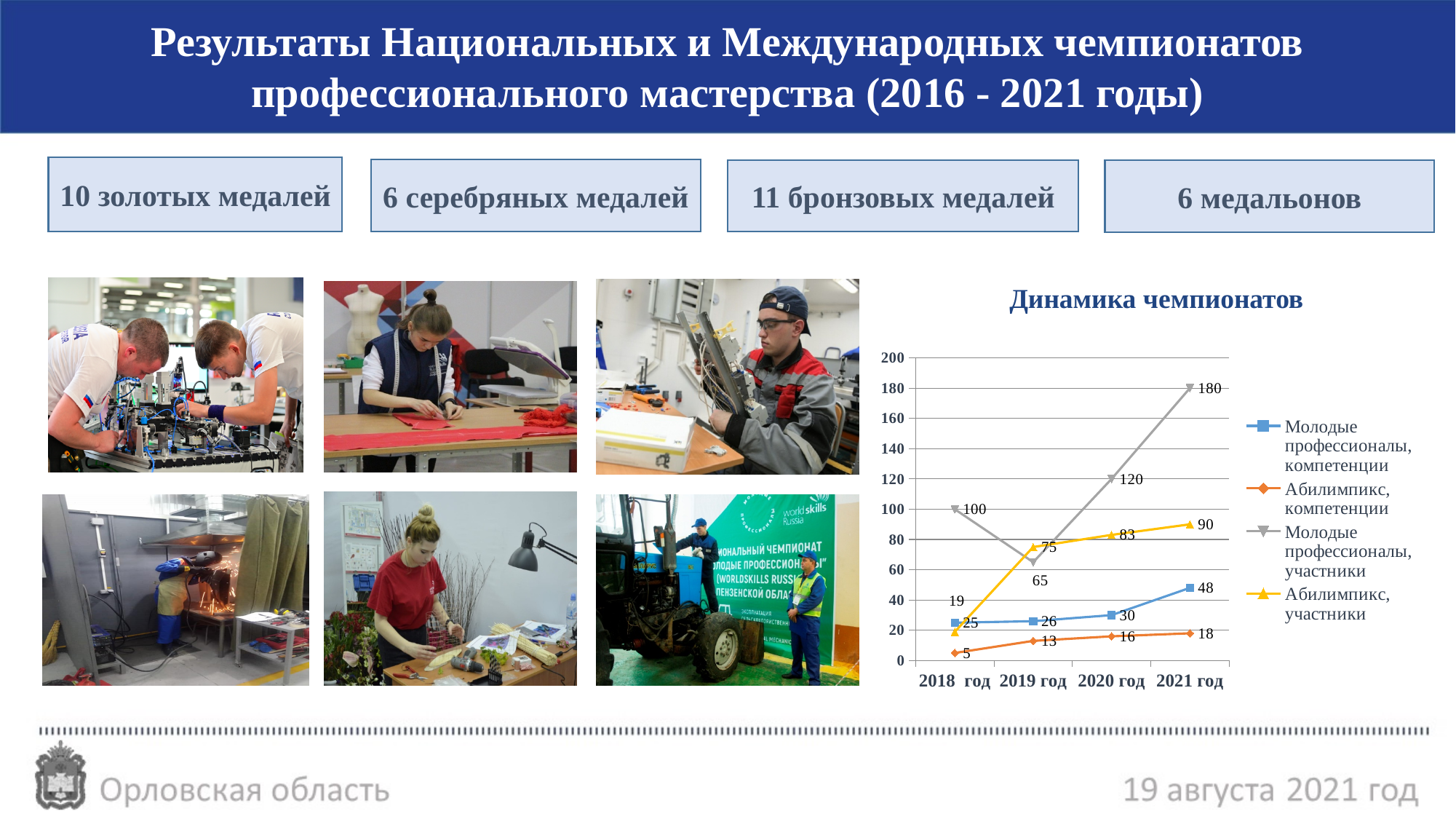
How many years are shown on the x axis of the "Динамика чемпионатов" chart? 4 What is the value for "Молодые профессионалы, компетенции" in 2020 год? 30 In which year is the value for "Абилимпикс, участники" highest? 2021 год Which is larger in 2018 год: "Молодые профессионалы, компетенции" or "Абилимпикс, участники"? Молодые профессионалы, компетенции How many series does the legend of the "Динамика чемпионатов" chart list? 4 What is the value for "Абилимпикс, компетенции" in 2018 год? 5 What type of chart is shown under the title "Динамика чемпионатов"? line chart What is the difference between the "Молодые профессионалы, участники" values in 2021 год and 2020 год? 60 What is the value for "Абилимпикс, участники" in 2019 год? 75 What is the value for "Молодые профессионалы, участники" in 2021 год? 180 Do the values for "Абилимпикс, компетенции" rise or fall from 2018 год to 2021 год? rise In which year is the value for "Молодые профессионалы, участники" lowest? 2019 год